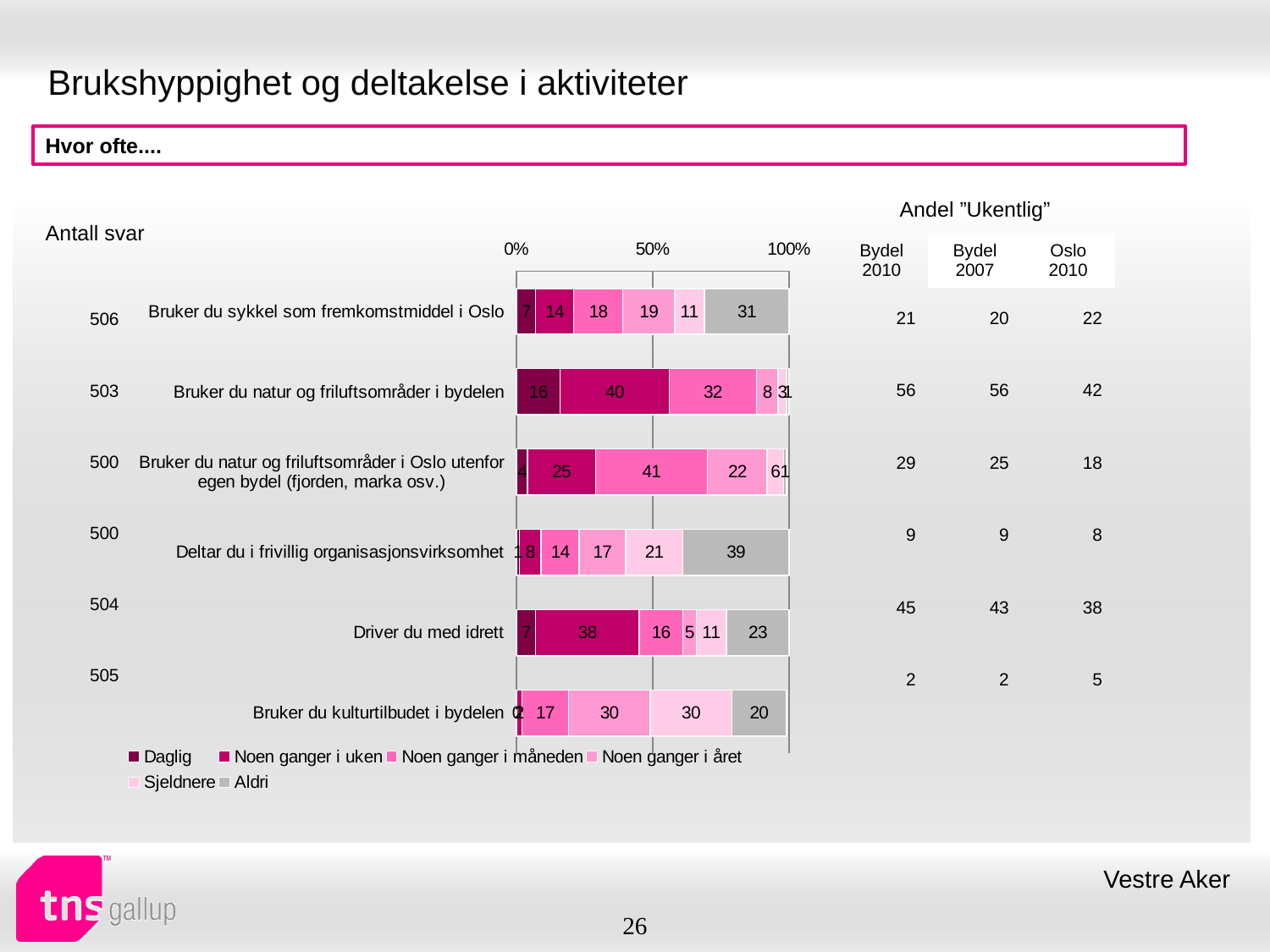
Which category has the highest 'Aldri' value? Deltar du i frivillig organisasjonsvirksomhet What is the 'Aldri' value for 'Bruker du sykkel som fremkomstmiddel i Oslo'? 31 Which has the larger 'Noen ganger i måneden' value: 'Bruker du sykkel som fremkomstmiddel i Oslo' or 'Bruker du natur og friluftsområder i Oslo utenfor egen bydel (fjorden, marka osv.)'? Bruker du natur og friluftsområder i Oslo utenfor egen bydel (fjorden, marka osv.) How many series does the chart legend list? 6 What is the first entry in the chart legend? Daglig How many categories (questions) are plotted in the chart? 6 What is the 'Noen ganger i måneden' value for 'Bruker du natur og friluftsområder i Oslo utenfor egen bydel (fjorden, marka osv.)'? 41 What is the 'Noen ganger i uken' value for 'Driver du med idrett'? 38 What is the 'Aldri' value for 'Deltar du i frivillig organisasjonsvirksomhet'? 39 What is the difference between the 'Aldri' values for 'Bruker du sykkel som fremkomstmiddel i Oslo' and 'Bruker du kulturtilbudet i bydelen'? 11 What is the 'Noen ganger i uken' value for 'Bruker du natur og friluftsområder i bydelen'? 40 What type of chart is shown on the slide? Stacked bar chart